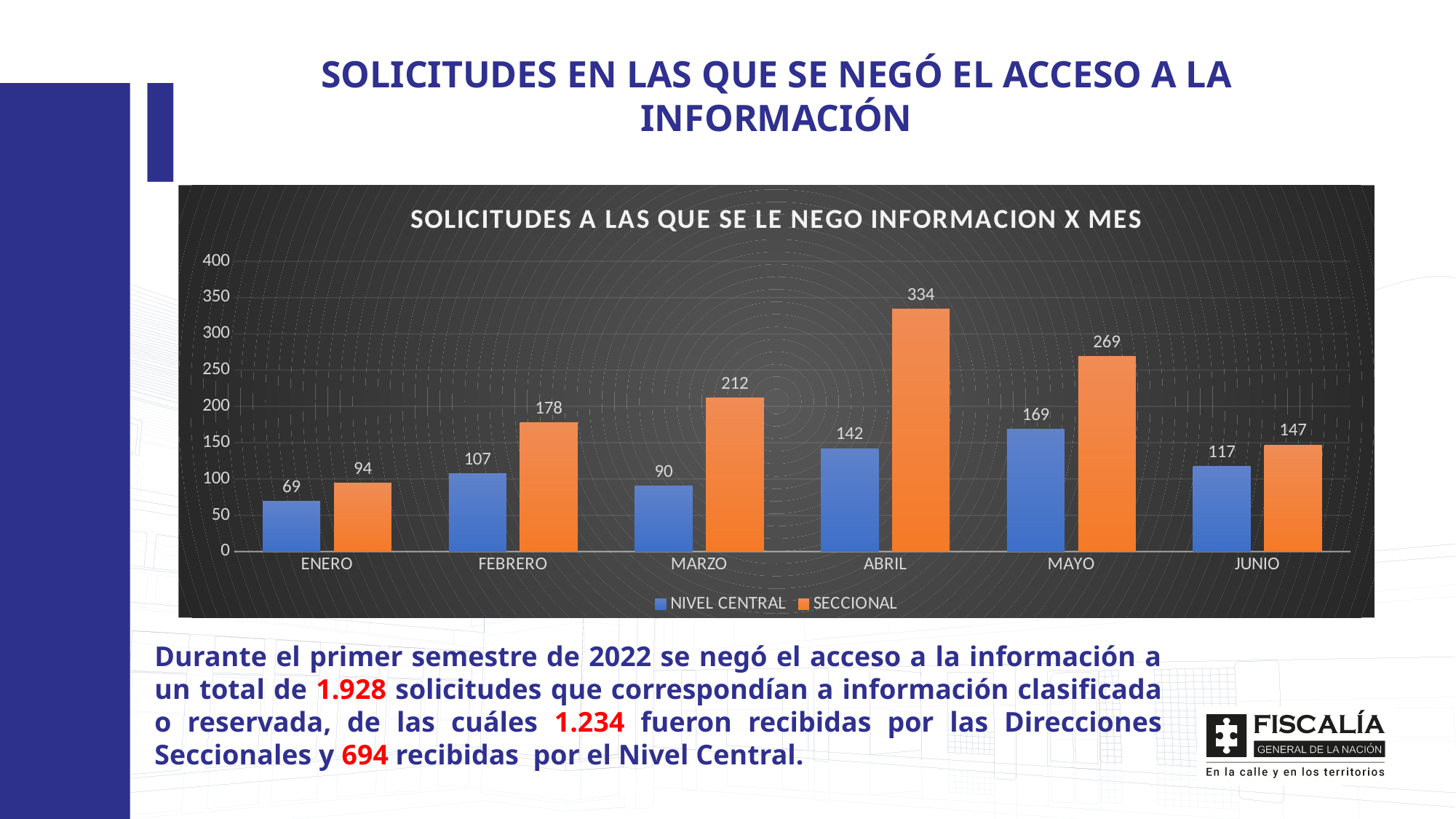
How many months are shown on the x axis? 6 Which month has the highest SECCIONAL value? ABRIL Which is larger in JUNIO, NIVEL CENTRAL or SECCIONAL? SECCIONAL Is the SECCIONAL value for ABRIL greater or less than 300? greater What is the title of the chart? SOLICITUDES A LAS QUE SE LE NEGO INFORMACION X MES How many series does the legend list? 2 What is the SECCIONAL value for MARZO? 212 What kind of chart is shown on the slide? Bar chart Which month has the lowest NIVEL CENTRAL value? ENERO What is the difference between the SECCIONAL and NIVEL CENTRAL values for MAYO? 100 Which colour represents the SECCIONAL series? Orange What is the NIVEL CENTRAL value for ABRIL? 142